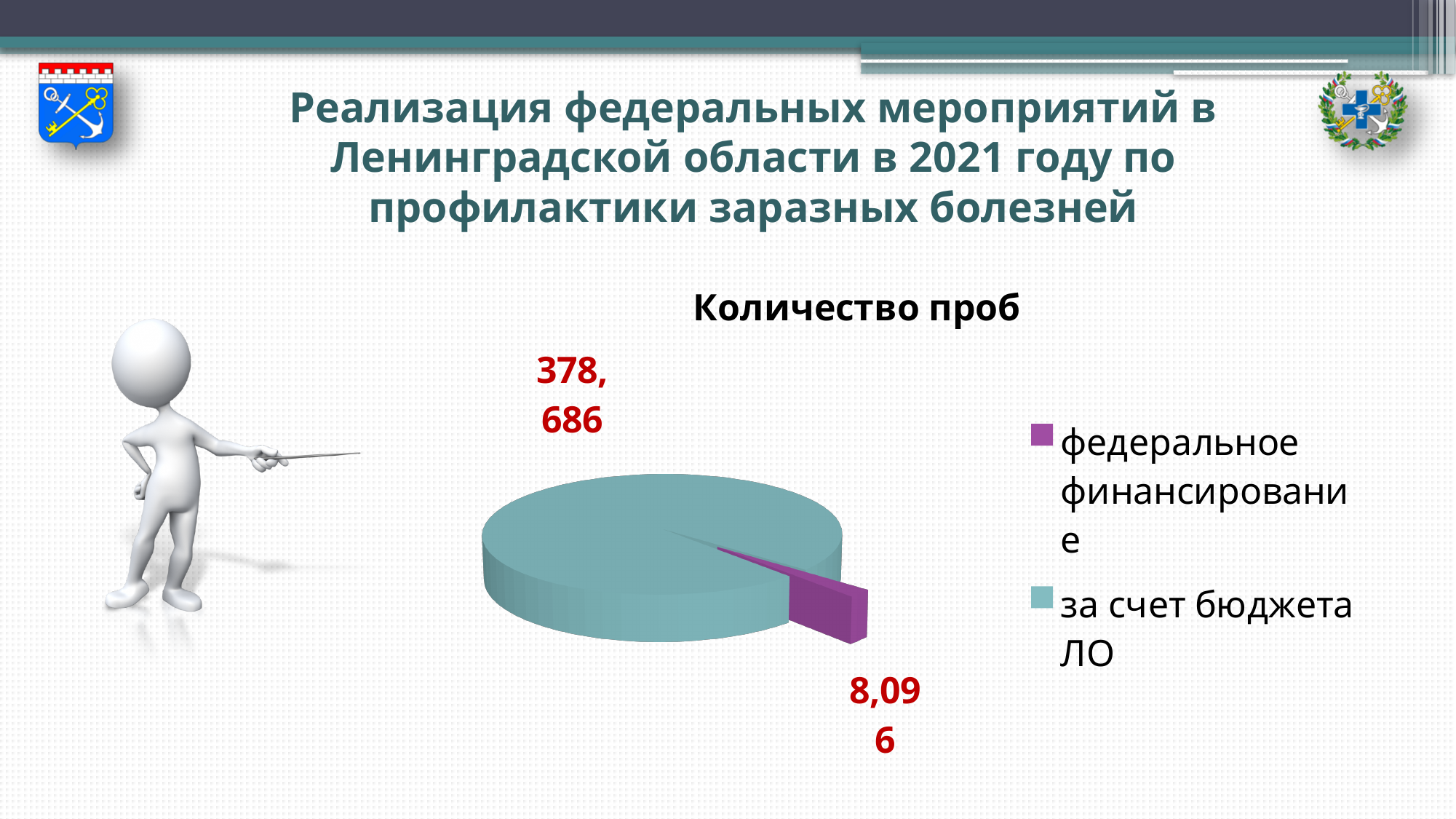
What is the total of the two values shown in the pie chart? 386,782 Which category has the largest slice of the pie? за счет бюджета ЛО What is the title of the chart? Количество проб What is the value for "за счет бюджета ЛО"? 378,686 What is the value for "федеральное финансирование"? 8,096 Which is larger: "федеральное финансирование" or "за счет бюджета ЛО"? за счет бюджета ЛО Which category has the smallest slice of the pie? федеральное финансирование How many entries does the legend list? 2 What kind of chart is shown on the slide? Pie chart What is the difference between the values for "за счет бюджета ЛО" and "федеральное финансирование"? 370,590 How many slices does the pie chart have? 2 What colour is the slice for "федеральное финансирование"? Purple